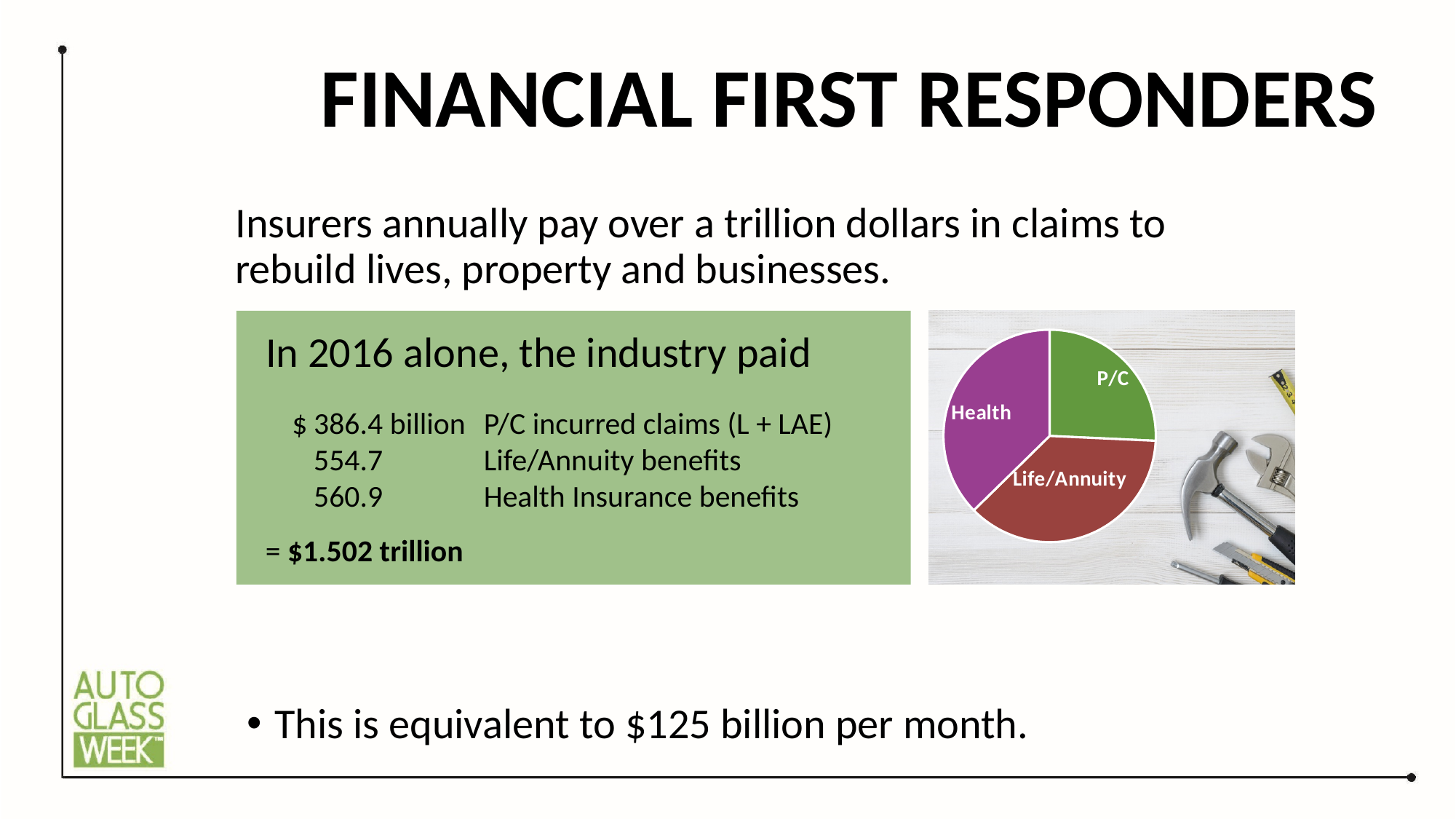
Which is larger, the Health slice or the P/C slice? Health According to the slide, how much did the industry pay in P/C incurred claims (L + LAE) in 2016? $386.4 billion What kind of chart is shown on the slide? pie chart What colour is the Health slice of the pie chart? purple What is the difference between the Life/Annuity benefits and the P/C incurred claims paid in 2016? 168.3 billion How many slices does the pie chart have? 3 What is the total amount the industry paid in 2016 across the three categories? $1.502 trillion According to the slide, how much did the industry pay in Life/Annuity benefits in 2016? 554.7 billion Which slice of the pie chart is the smallest? P/C According to the slide, how much did the industry pay in Health Insurance benefits in 2016? 560.9 billion What colour is the P/C slice of the pie chart? green What is the difference between the Health Insurance benefits and the P/C incurred claims paid in 2016? 174.5 billion